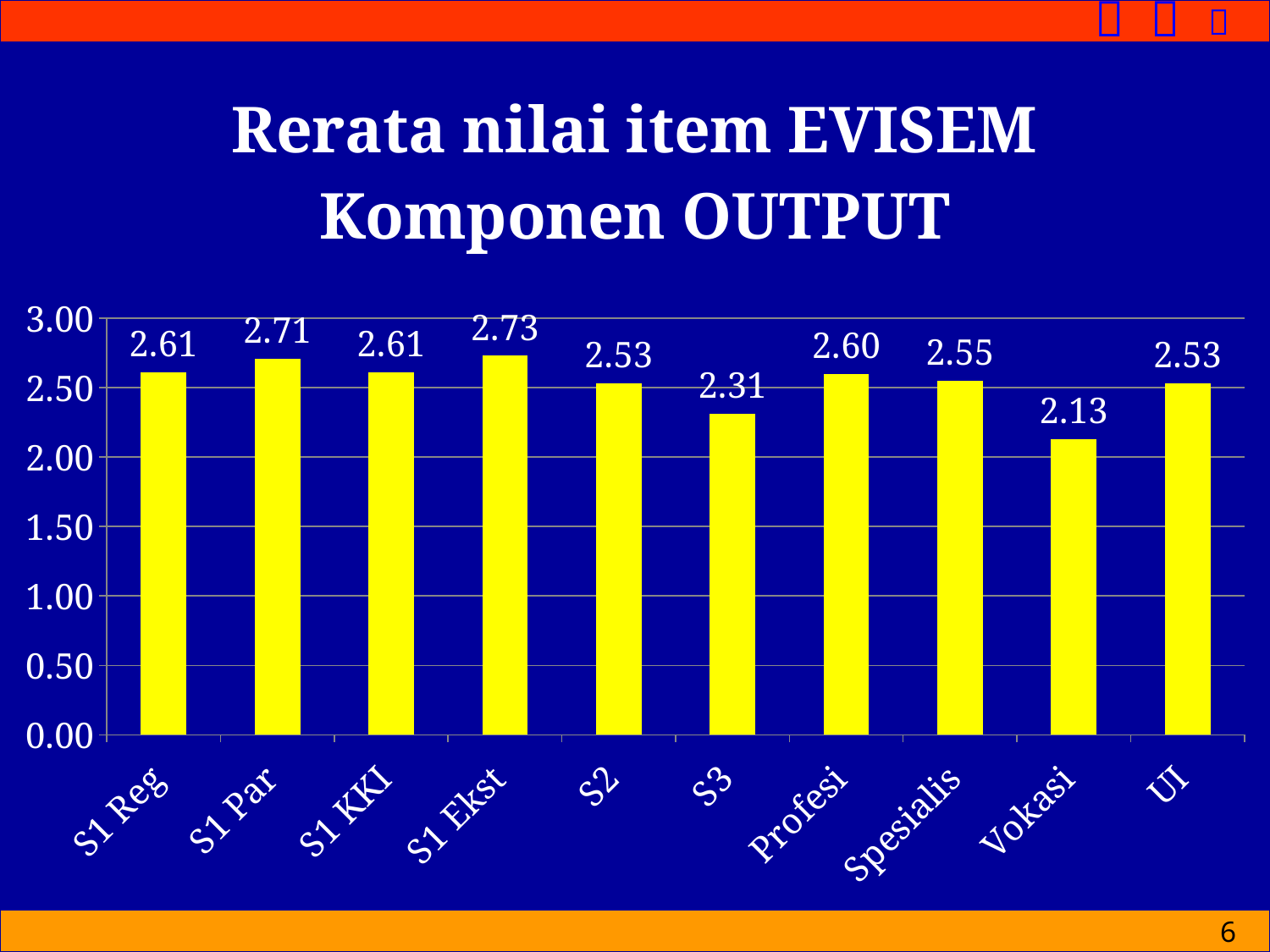
Is the value for S3 greater or less than 2.50? less What is the difference between the values for S1 Par and S3? 0.40 What is the value for S1 Ekst? 2.73 Which is larger, the value for Spesialis or the value for S3? Spesialis Which category has the lowest value? Vokasi What is the value for Profesi? 2.60 What kind of chart is shown on the slide? bar chart What is the difference between the values for S1 Ekst and Vokasi? 0.60 What is the title of the slide? Rerata nilai item EVISEM Komponen OUTPUT How many categories are shown on the x axis? 10 What is the value for Vokasi? 2.13 Which category has the highest value? S1 Ekst